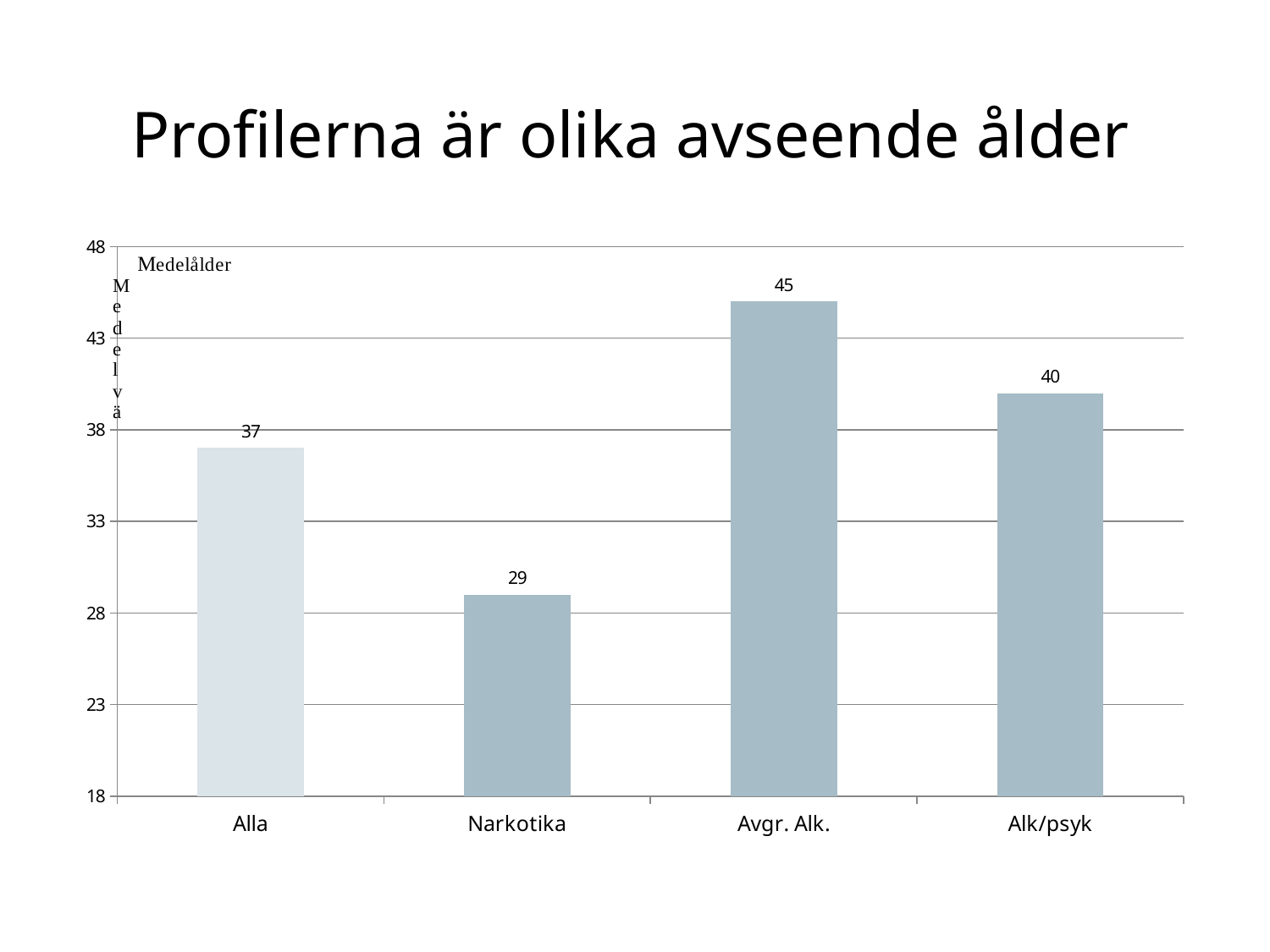
What is the title of the slide? Profilerna är olika avseende ålder What is the value for Avgr. Alk.? 45 What is the value for Narkotika? 29 Which category has the highest value? Avgr. Alk. What kind of chart is shown on the slide? Bar chart What is the value for Alla? 37 Which category has the lowest value? Narkotika What is the difference between the values for Avgr. Alk. and Narkotika? 16 What is the difference between the values for Alk/psyk and Alla? 3 How many categories are shown on the x axis? 4 What is the value for Alk/psyk? 40 Which is larger, the value for Alla or the value for Alk/psyk? Alk/psyk